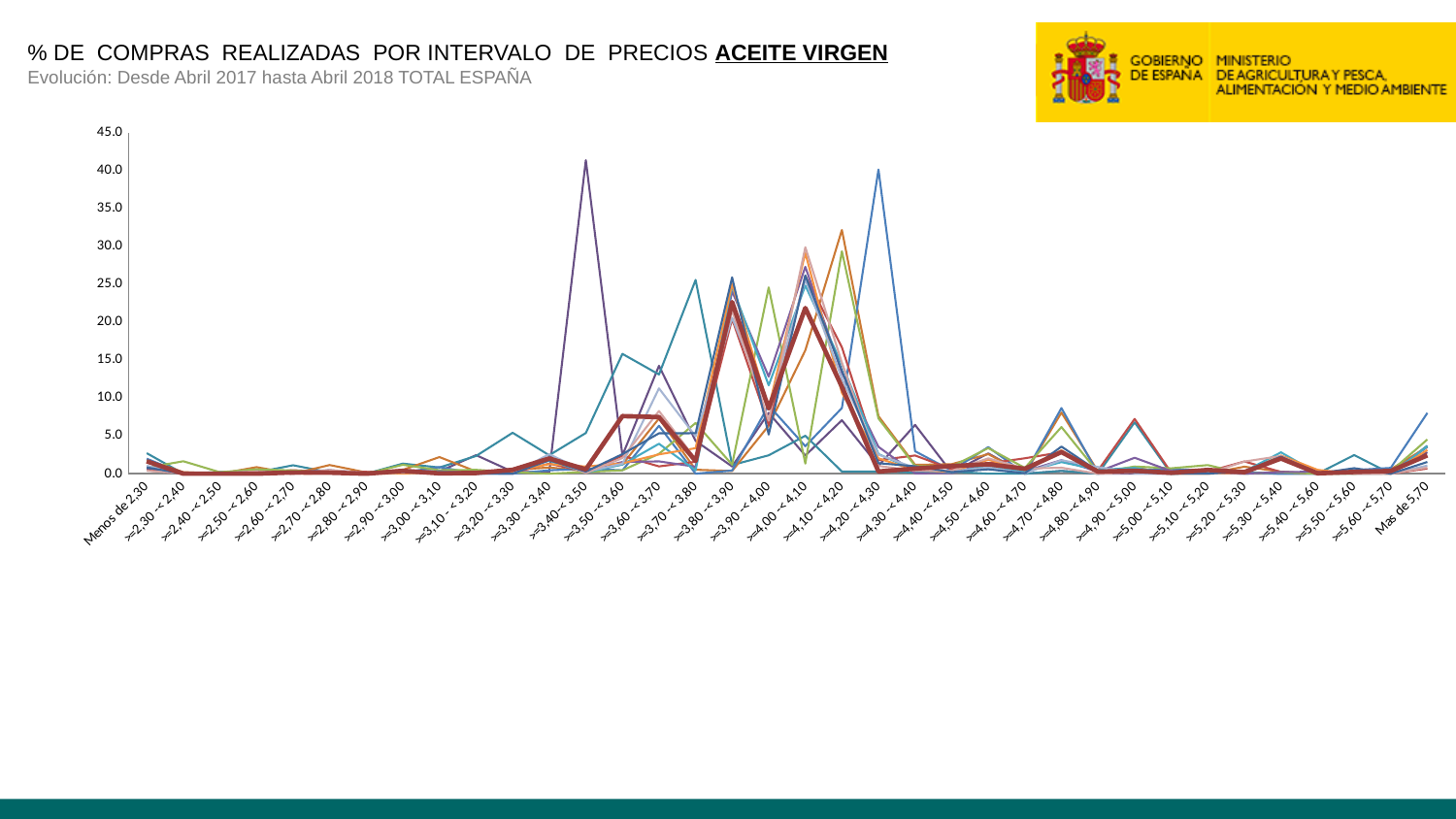
What is the last category on the x axis of the chart? Mas de 5,70 How many price-interval categories are shown along the x axis of the chart? 36 Are all the values plotted at the category Menos de 2,30 greater or less than 5.0? less Is the highest value plotted at the interval 4,10 - < 4,20 greater or less than 25? greater Is the highest value plotted at the interval 3,40 - < 3,50 greater or less than 35? greater What kind of chart is shown on the slide? Line chart What is the highest tick value shown on the y axis of the chart? 45.0 What is the first category on the x axis of the chart? Menos de 2,30 What product is named in the chart title? ACEITE VIRGEN